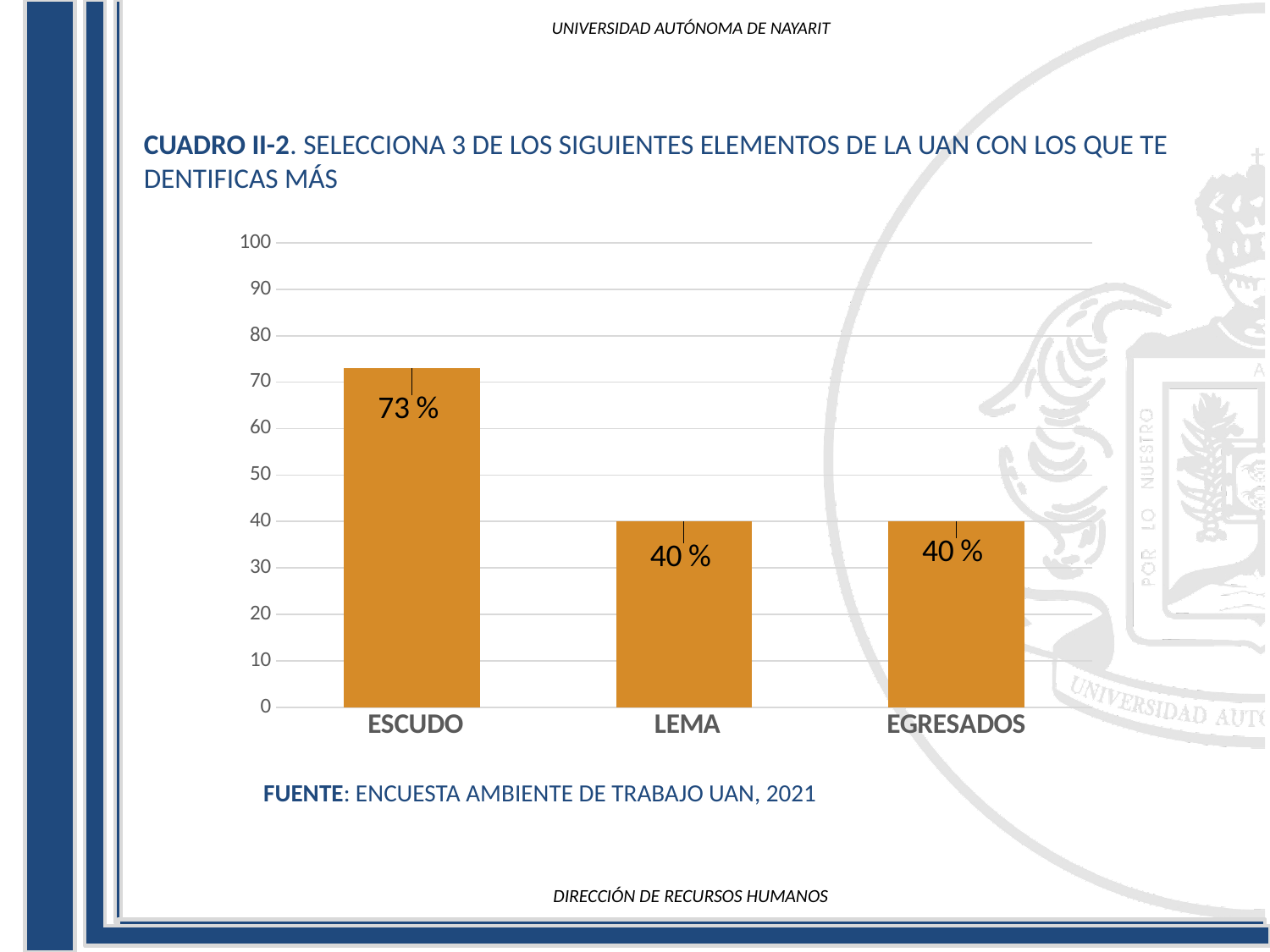
Is the value for ESCUDO greater or less than 70? greater What is the value for ESCUDO? 73 % Is the value for LEMA greater or less than 50? less What is the difference between the values for ESCUDO and LEMA? 33 % What source is cited below the chart? ENCUESTA AMBIENTE DE TRABAJO UAN, 2021 Which category has the highest value? ESCUDO Which is larger, the value for ESCUDO or the value for EGRESADOS? ESCUDO What is the value for LEMA? 40 % What kind of chart is shown on the slide? bar chart How many categories are shown on the x axis? 3 What is the highest value shown on the y axis? 100 What is the value for EGRESADOS? 40 %